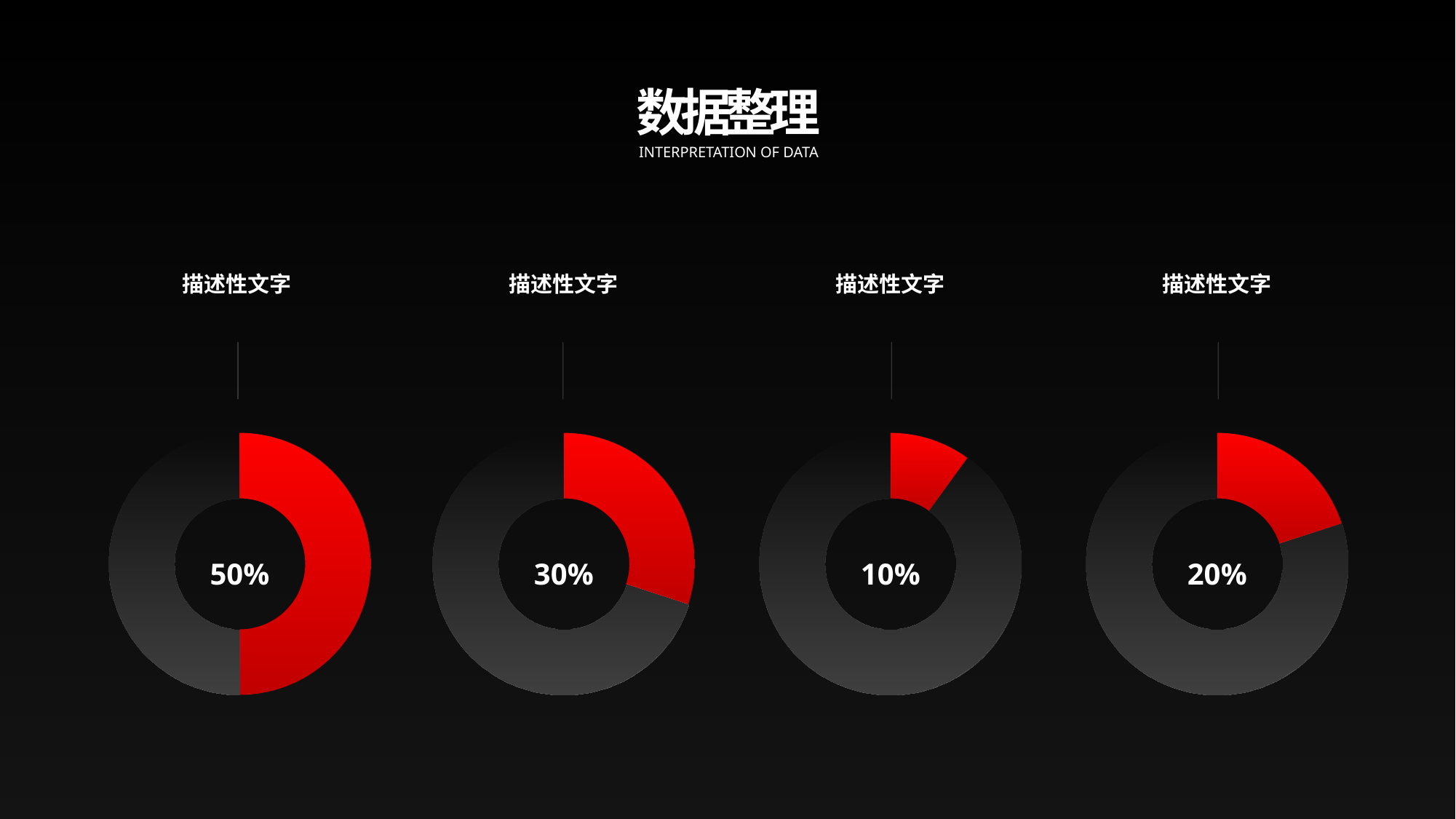
What kind of chart is used on this slide? Donut (pie) chart What is the English subtitle shown under the slide title? INTERPRETATION OF DATA How many donut charts are on the slide? 4 What colour is used for the filled portion of each donut chart? Red What is the difference between the percentage in the leftmost donut chart and the percentage in the rightmost donut chart? 30% What value is shown in the centre of the third donut chart from the left? 10% Which is larger: the percentage in the second donut chart from the left or the percentage in the rightmost donut chart? The second chart from the left (30%) What value is shown in the centre of the second donut chart from the left? 30% Which of the four donut charts shows the highest percentage? The leftmost chart (50%) What value is shown in the centre of the rightmost donut chart? 20% What value is shown in the centre of the leftmost donut chart? 50% Which of the four donut charts shows the lowest percentage? The third chart from the left (10%)